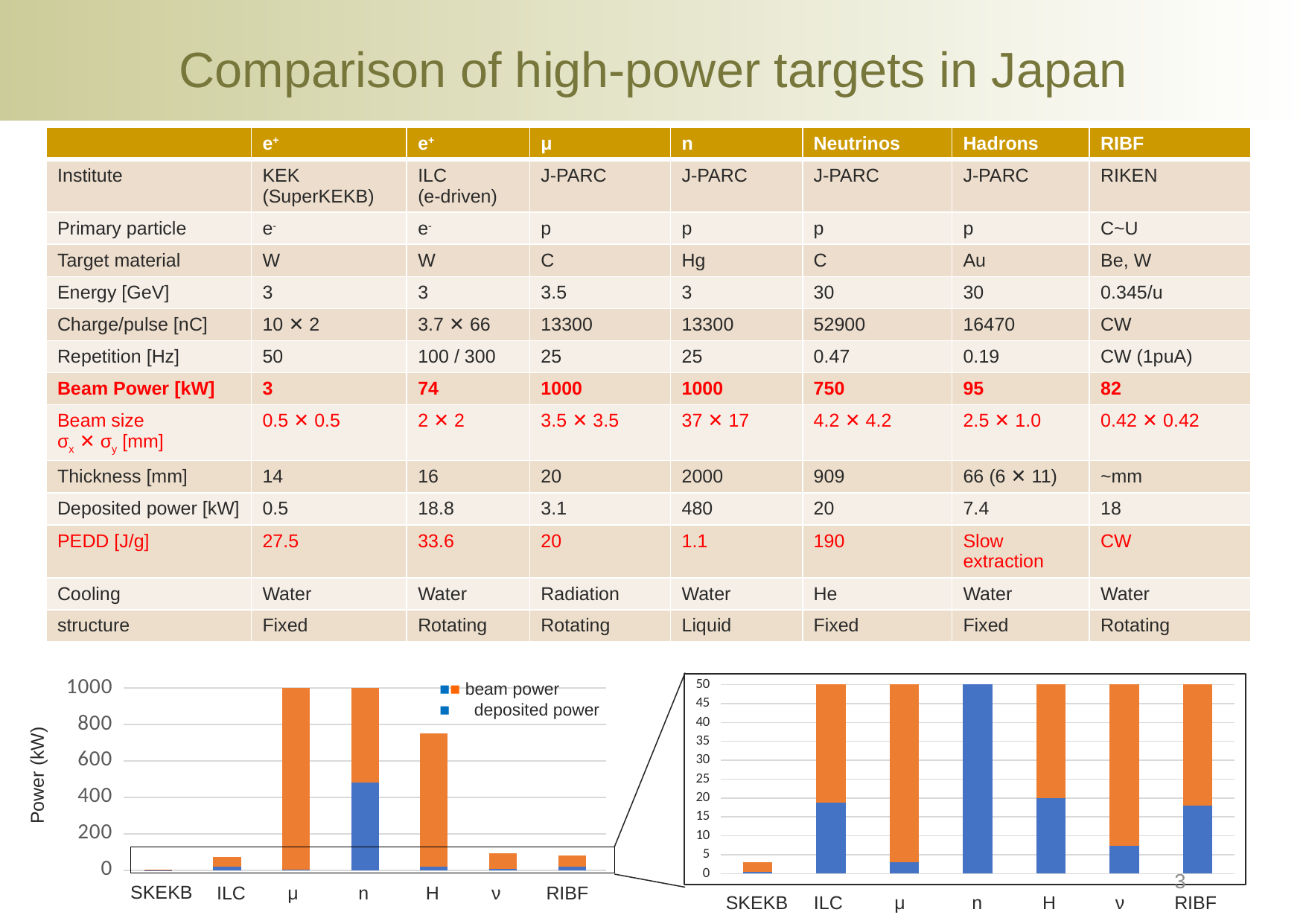
In the left chart, which category has the lowest beam power? SKEKB How many categories are shown on the x axis of the left chart? 7 What is the y-axis label of the left chart? Power (kW) In the left chart, which category has the highest deposited power? n In the left chart, is the beam power for ν greater or less than 200? less In the left chart, what is the beam power for μ? 1000 What kind of chart is the left chart on the slide? bar chart In the right (zoomed) chart, is the deposited power for ν greater or less than 10? less In the left chart, is the deposited power for n greater or less than 400? greater How many series does the legend of the left chart list? 2